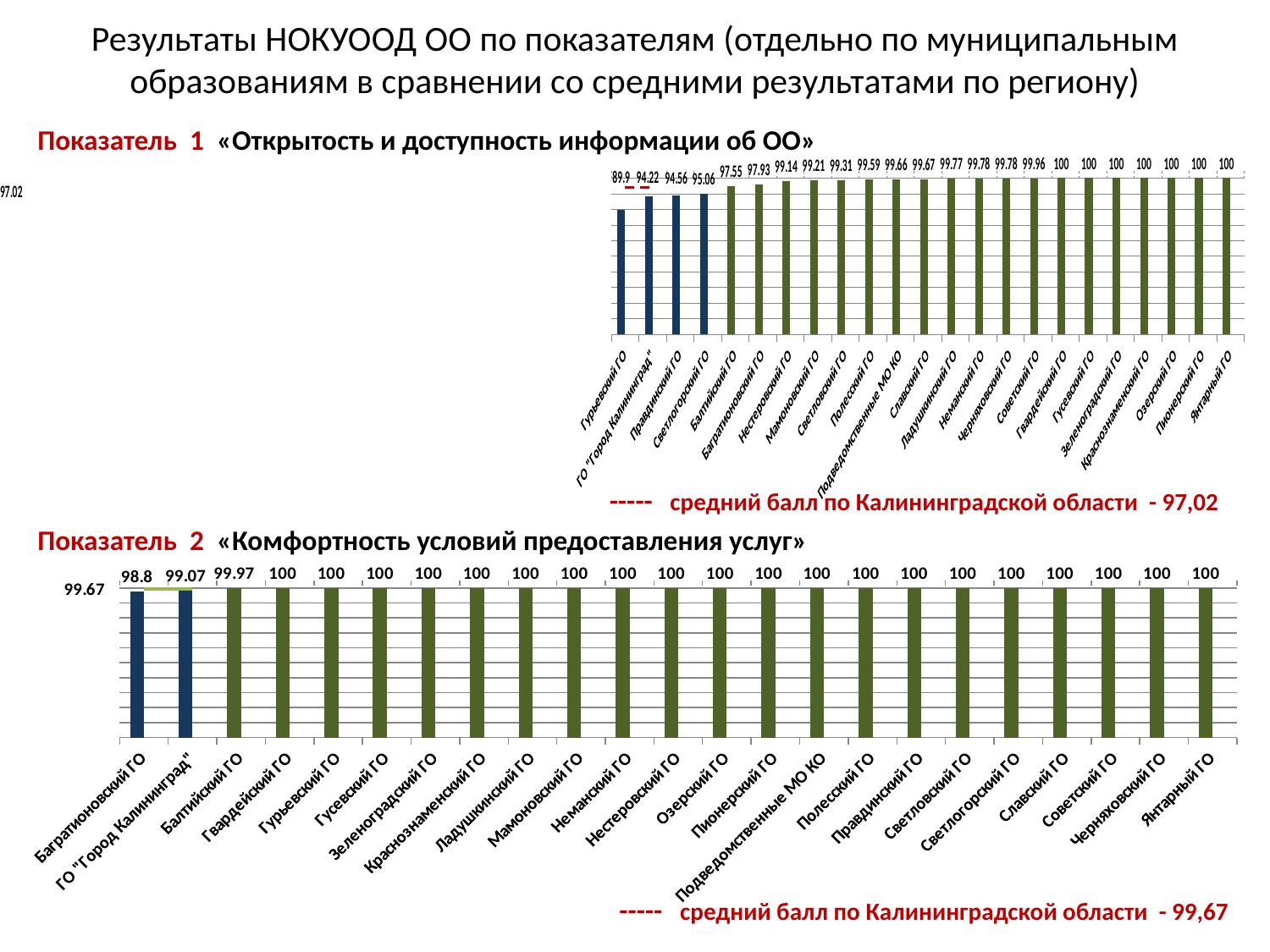
In the chart for Показатель 2 «Комфортность условий предоставления услуг», what is the value for Багратионовский ГО? 98.8 How many categories are shown in the chart for Показатель 2 «Комфортность условий предоставления услуг»? 23 In the chart for Показатель 1 «Открытость и доступность информации об ОО», what is the value for Гурьевский ГО? 89.9 In the chart for Показатель 2 «Комфортность условий предоставления услуг», what is the difference between the values for ГО "Город Калининград" and Багратионовский ГО? 0.27 In the chart for Показатель 1 «Открытость и доступность информации об ОО», which category has the lowest value? Гурьевский ГО In the chart for Показатель 1 «Открытость и доступность информации об ОО», what is the value for Советский ГО? 99.96 What type of chart is used for Показатель 2 «Комфортность условий предоставления услуг»? Bar chart In the chart for Показатель 2 «Комфортность условий предоставления услуг», which category has the lowest value? Багратионовский ГО In the chart for Показатель 1 «Открытость и доступность информации об ОО», what is the value for ГО "Город Калининград"? 94.22 In the chart for Показатель 2 «Комфортность условий предоставления услуг», what is the value for Балтийский ГО? 99.97 In the chart for Показатель 1 «Открытость и доступность информации об ОО», which is larger: the value for Балтийский ГО or the value for Багратионовский ГО? Багратионовский ГО In the chart for Показатель 1 «Открытость и доступность информации об ОО», what is the difference between the values for Светлогорский ГО and Правдинский ГО? 0.5